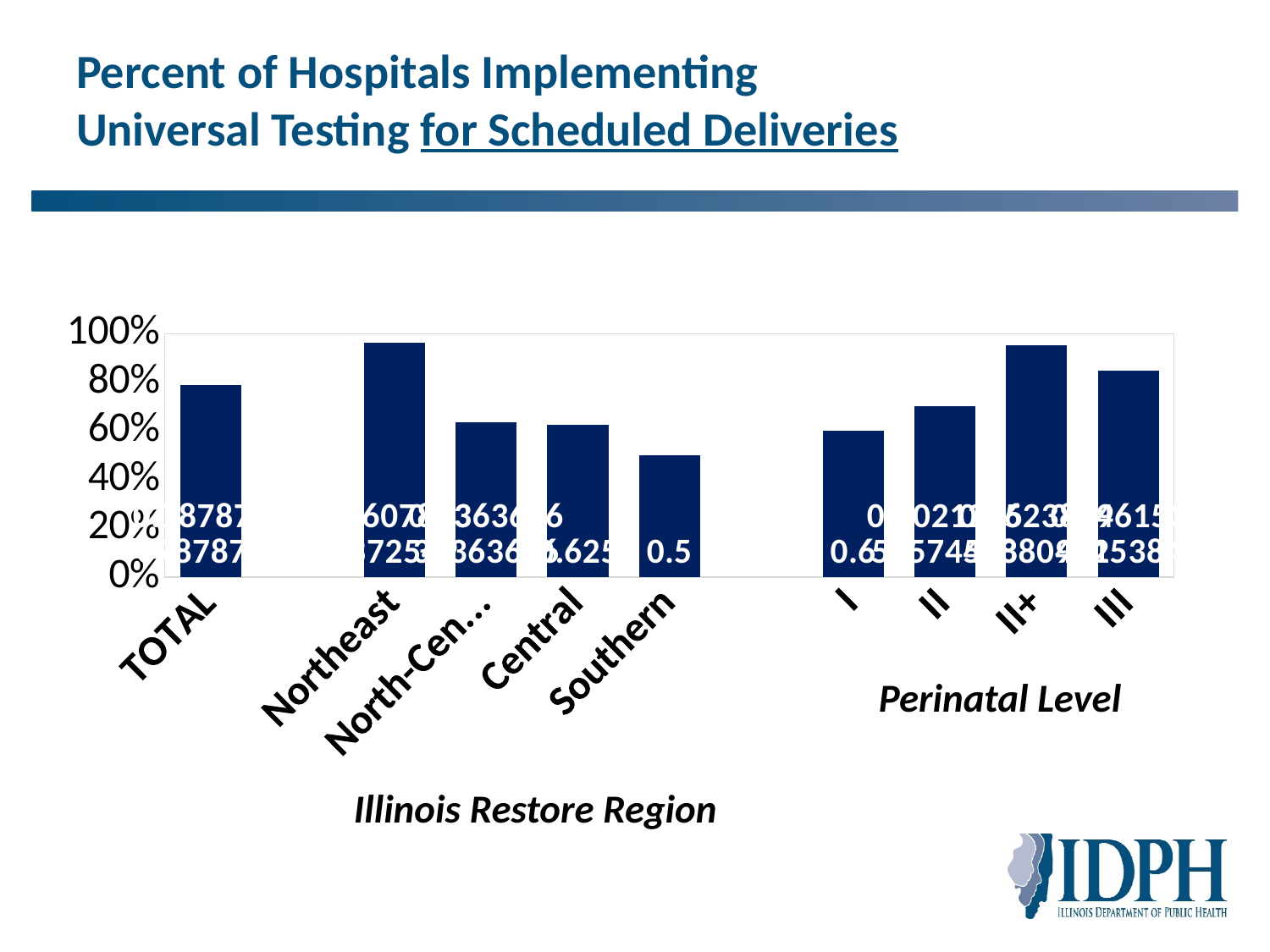
What kind of chart is shown on the slide? bar chart Is the value for Southern greater or less than 60%? less Which category has the lowest bar in the chart? Southern Which has the larger value, Northeast or Southern? Northeast How many bars are plotted in the chart? 9 Is the value for Central greater or less than 80%? less Is the value for Perinatal Level II+ greater or less than 80%? greater What are the two group labels shown beneath the x axis of the chart? Illinois Restore Region and Perinatal Level Which has the larger value, Perinatal Level II or Perinatal Level I? II Among the Illinois Restore Region bars (excluding TOTAL), which region has the highest bar? Northeast